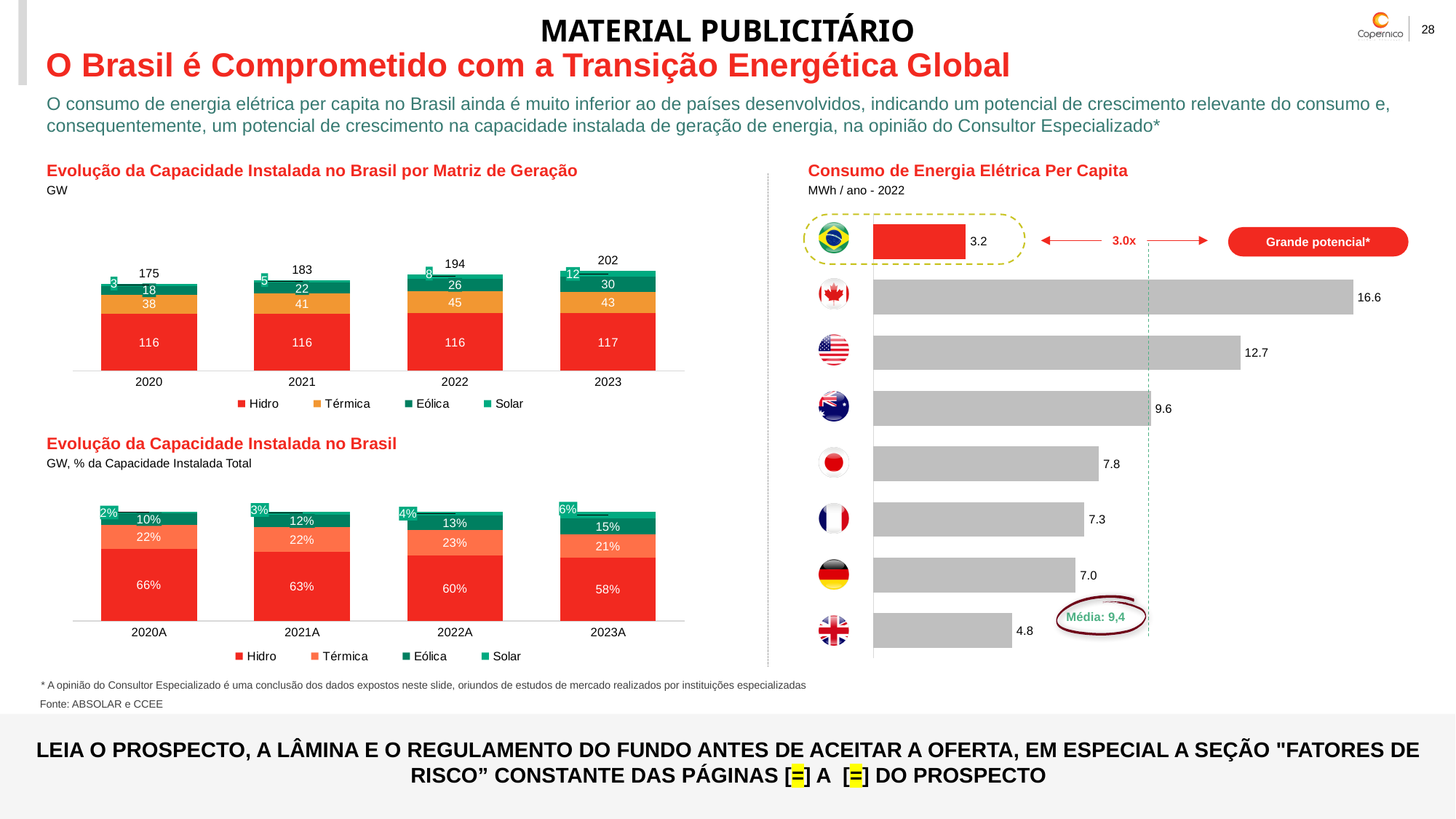
In the chart 'Evolução da Capacidade Instalada no Brasil por Matriz de Geração', by how much did the Solar value increase from 2020 to 2023? 9 In the chart 'Evolução da Capacidade Instalada no Brasil por Matriz de Geração', does the total installed capacity rise or fall from 2020 to 2023? rise In the chart 'Evolução da Capacidade Instalada no Brasil por Matriz de Geração', what is the Eólica value for 2021? 22 What kind of chart is 'Consumo de Energia Elétrica Per Capita'? bar chart In the chart 'Evolução da Capacidade Instalada no Brasil' (GW, % da Capacidade Instalada Total), what is the Eólica share for 2022A? 13% In the chart 'Evolução da Capacidade Instalada no Brasil por Matriz de Geração', what is the total installed capacity for 2023? 202 In the chart 'Evolução da Capacidade Instalada no Brasil' (GW, % da Capacidade Instalada Total), what is the Hidro share for 2023A? 58% In the chart 'Consumo de Energia Elétrica Per Capita', what is the value for Brazil? 3.2 How many series does the legend of the chart 'Evolução da Capacidade Instalada no Brasil por Matriz de Geração' list? 4 In the chart 'Evolução da Capacidade Instalada no Brasil por Matriz de Geração', what is the Térmica value for 2022? 45 In the chart 'Evolução da Capacidade Instalada no Brasil' (GW, % da Capacidade Instalada Total), which year has the highest Hidro share? 2020A In the chart 'Consumo de Energia Elétrica Per Capita', what is the highest value shown? 16.6